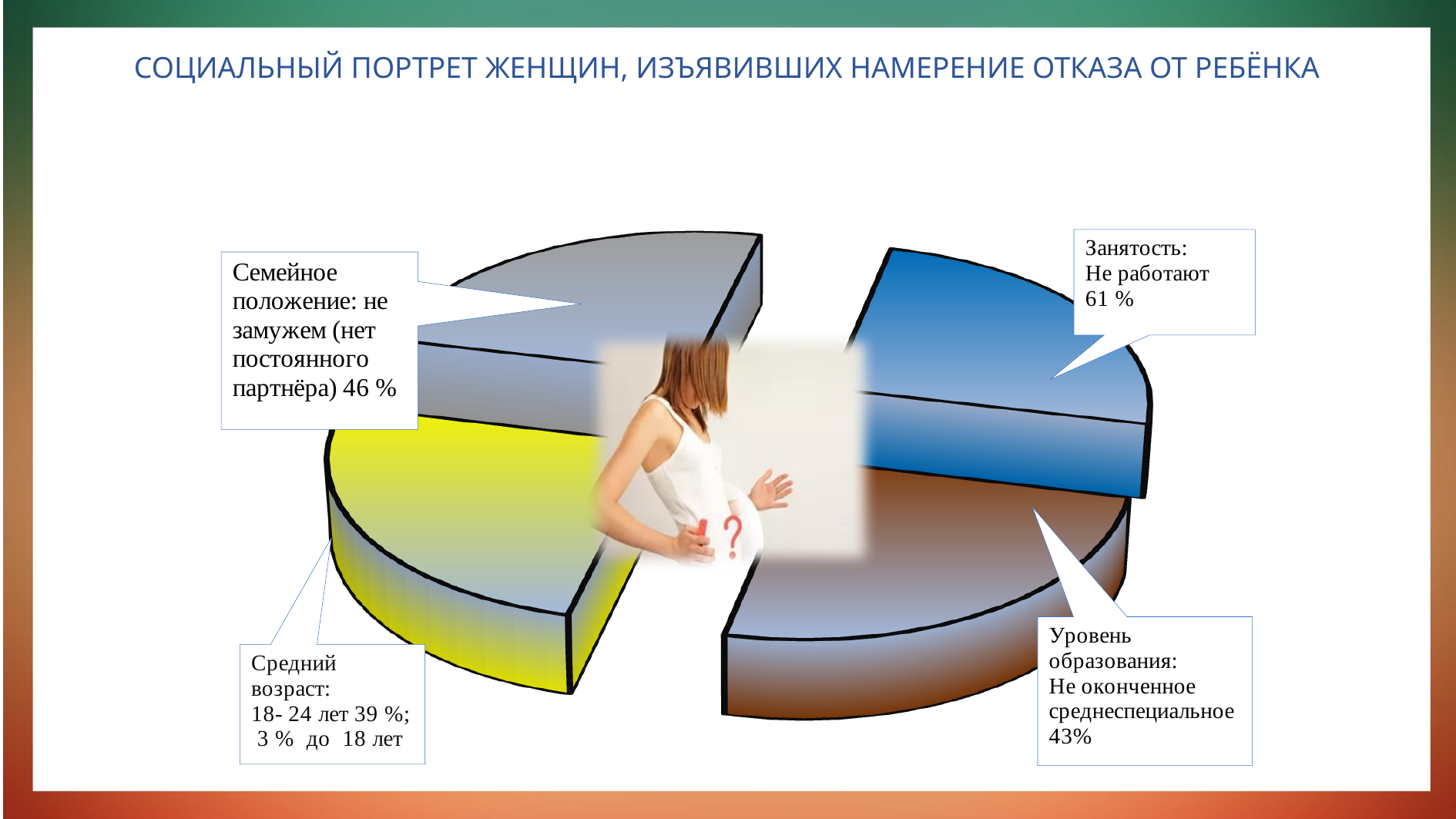
What percentage is given for 'Занятость: Не работают'? 61 % What percentage is given for the age group 18-24 лет under 'Средний возраст'? 39 % What kind of chart is shown on the slide? pie chart Which is larger: the value for 'Не работают' or the value for 'не замужем'? Не работают What percentage is given for 'Уровень образования: Не оконченное среднеспециальное'? 43% Which labelled value on the chart is the highest? Не работают, 61 % What colour is the slice labelled 'Занятость: Не работают 61 %'? blue Which labelled value on the chart is the lowest? до 18 лет, 3 % What percentage is given for 'Семейное положение: не замужем (нет постоянного партнёра)'? 46 % How many slices does the pie chart have? 4 What is the difference between the value for 'Не работают' (61 %) and the value for 'не замужем' (46 %)? 15 % What percentage is given for women under 18 лет ('до 18 лет')? 3 %